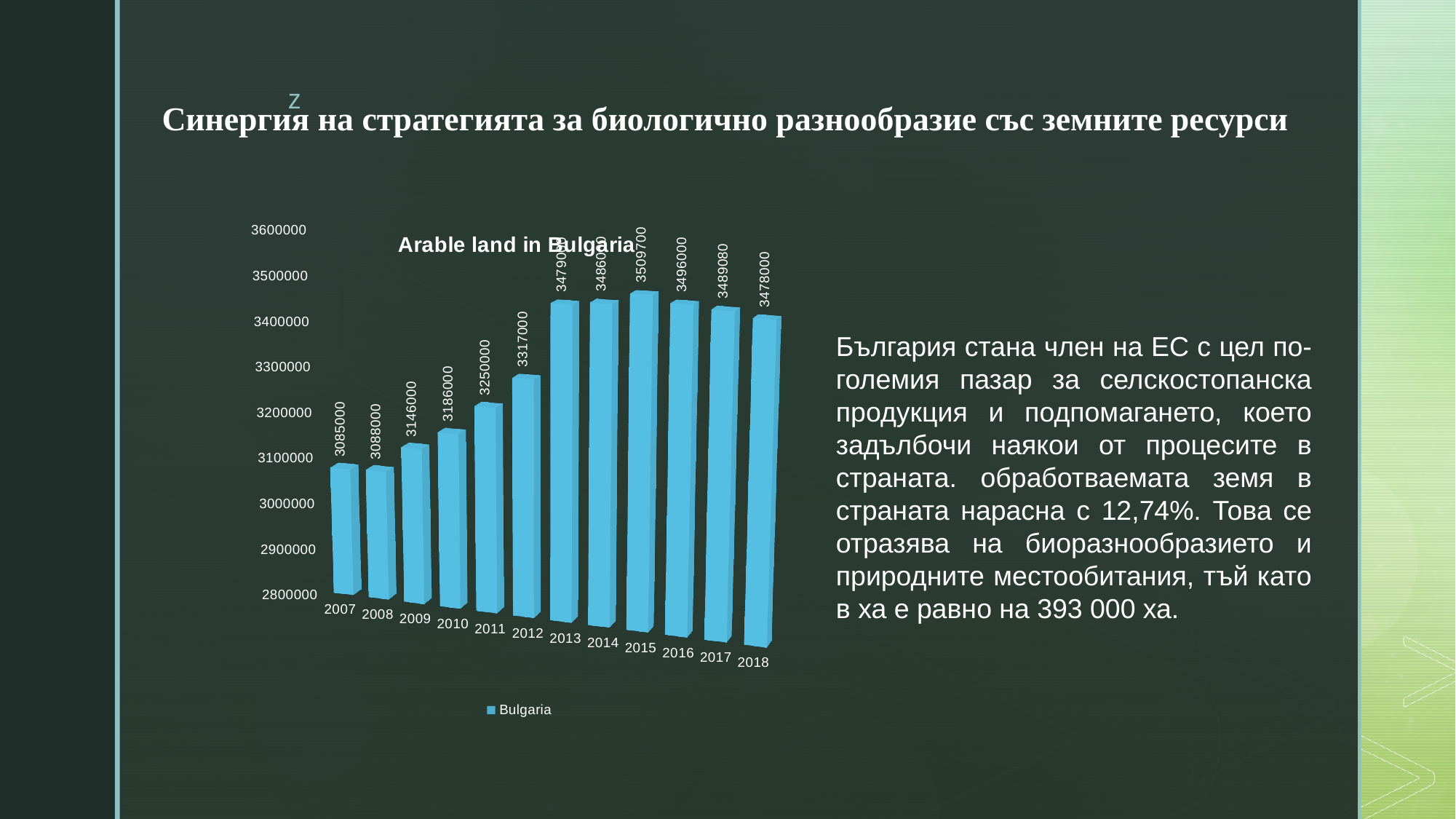
What is the title of the chart? Arable land in Bulgaria What is the value for 2015? 3509700 What is the value for 2018? 3478000 What is the difference between the values for 2012 and 2011? 67000 What is the value for 2007? 3085000 Is the value for 2010 greater or less than 3200000? less Do the values rise or fall from 2007 to 2012? rise How many years are plotted on the chart? 12 How many series does the legend list? 1 Which is larger, the value for 2016 or the value for 2017? 2016 What kind of chart is shown on the slide? bar chart Which year has the highest value? 2015